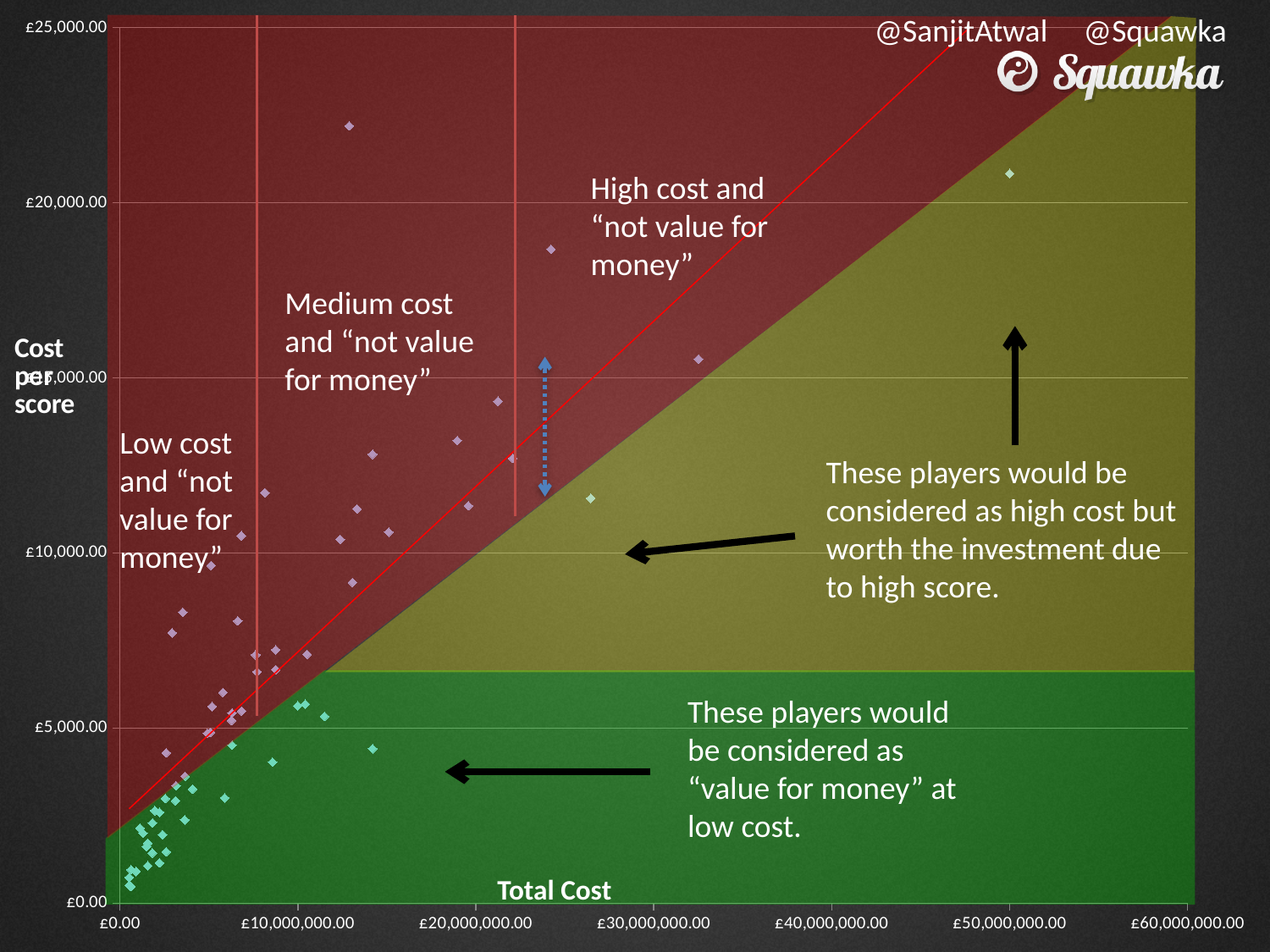
What is the title of the y axis of the chart? Cost per score What is the title of the x axis of the chart? Total Cost What kind of chart is shown on the slide? scatter chart Do the plotted points generally rise or fall as Total Cost increases along the x axis? rise